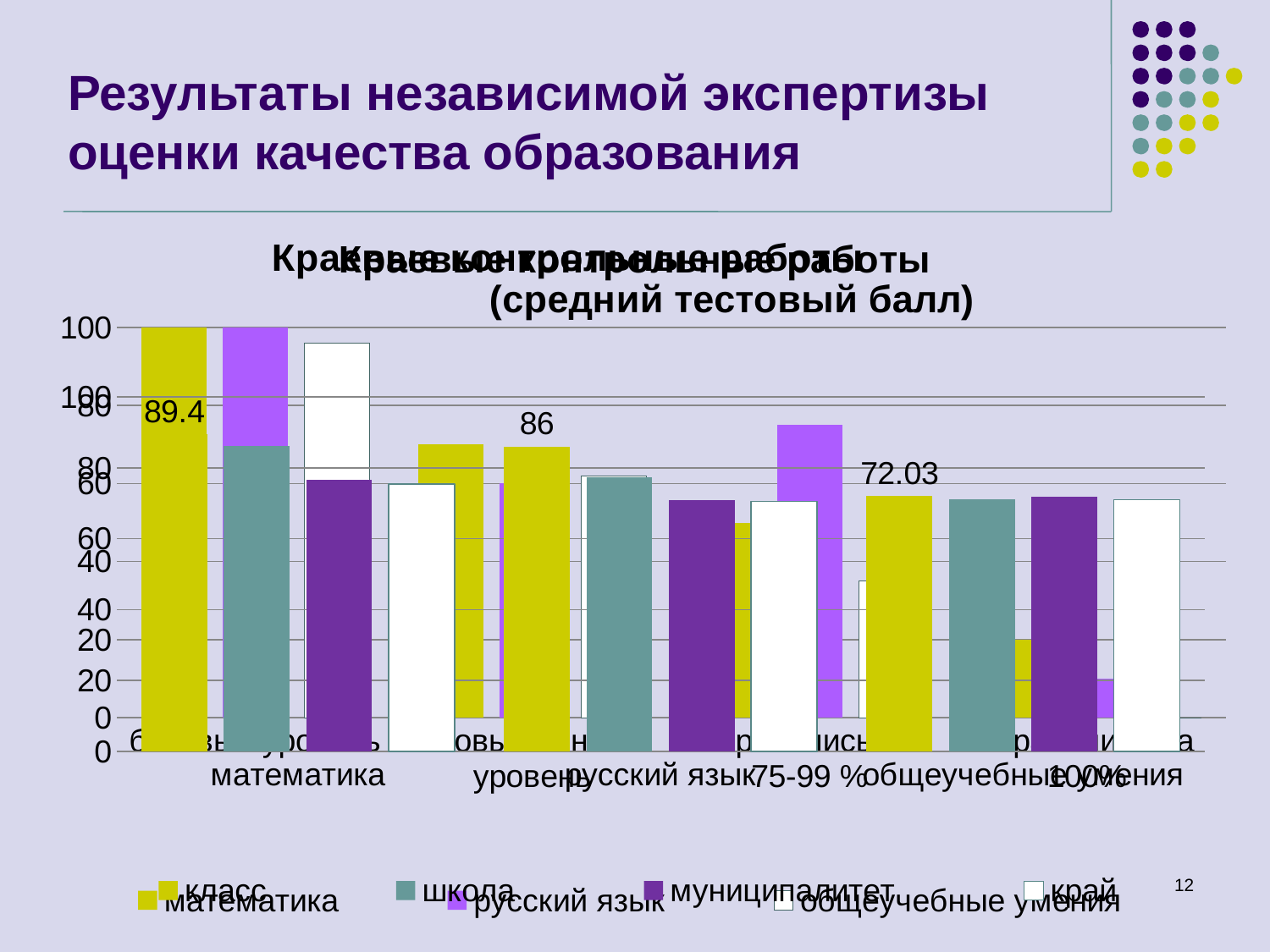
In the chart titled 'Краевые контрольные работы (средний тестовый балл)', which category has the highest labelled value for класс? математика In the chart titled 'Краевые контрольные работы (средний тестовый балл)', which category has the lowest labelled value for класс? общеучебные умения In the chart titled 'Краевые контрольные работы (средний тестовый балл)', what value is labelled for класс in русский язык? 86 What type of chart is shown on the slide? bar chart How many series does the legend of the chart titled 'Краевые контрольные работы (средний тестовый балл)' list? 4 In the chart titled 'Краевые контрольные работы (средний тестовый балл)', do the labelled класс values rise or fall from математика to общеучебные умения? fall In the chart titled 'Краевые контрольные работы (средний тестовый балл)', what value is labelled for класс in общеучебные умения? 72.03 In the chart titled 'Краевые контрольные работы (средний тестовый балл)', which is larger: the labelled класс value for математика or for русский язык? математика In the chart titled 'Краевые контрольные работы (средний тестовый балл)', what value is labelled for класс in математика? 89.4 What are the legend entries of the chart titled 'Краевые контрольные работы (средний тестовый балл)'? класс, школа, муниципалитет, край How many categories are shown on the x axis of the chart titled 'Краевые контрольные работы (средний тестовый балл)'? 3 In the chart titled 'Краевые контрольные работы (средний тестовый балл)', what is the difference between the labelled класс values for математика and общеучебные умения? 17.37